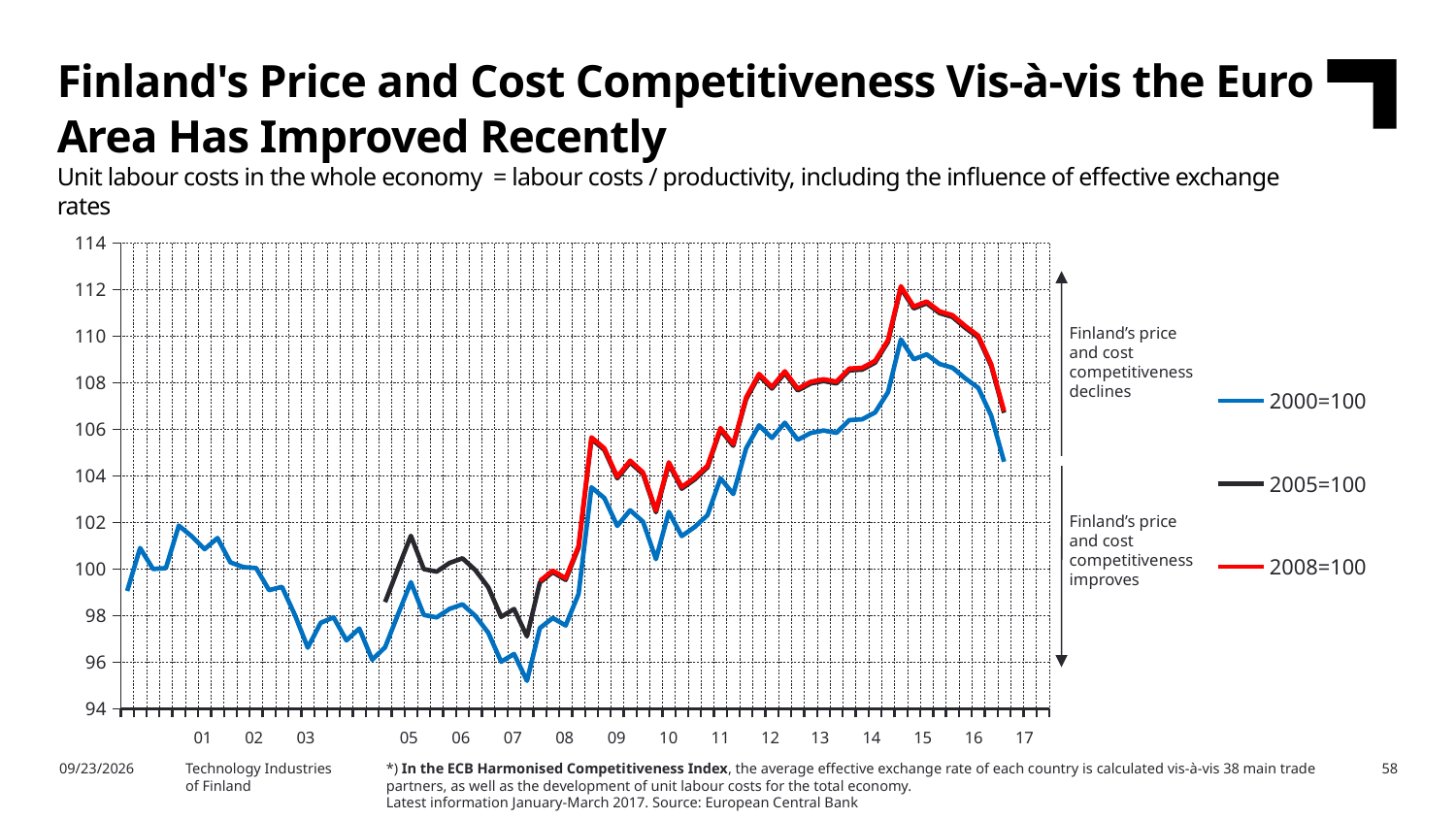
Is the value of the 2000=100 series at the end of the chart in 2017 greater or less than 102? greater What is the highest value shown on the vertical axis? 114 Is the peak value of the 2005=100 series in 2005 greater or less than 100? greater Is the peak value of the 2008=100 series around 2015 greater or less than 110? greater Does the 2000=100 series rise or fall between 2015 and 2017? fall Which series is drawn in red according to the legend? 2008=100 Around 2015, which series has the higher value, 2008=100 or 2000=100? 2008=100 What kind of chart is shown on the slide? line chart Which series reaches the highest value on the chart? 2008=100 How many series does the legend list? 3